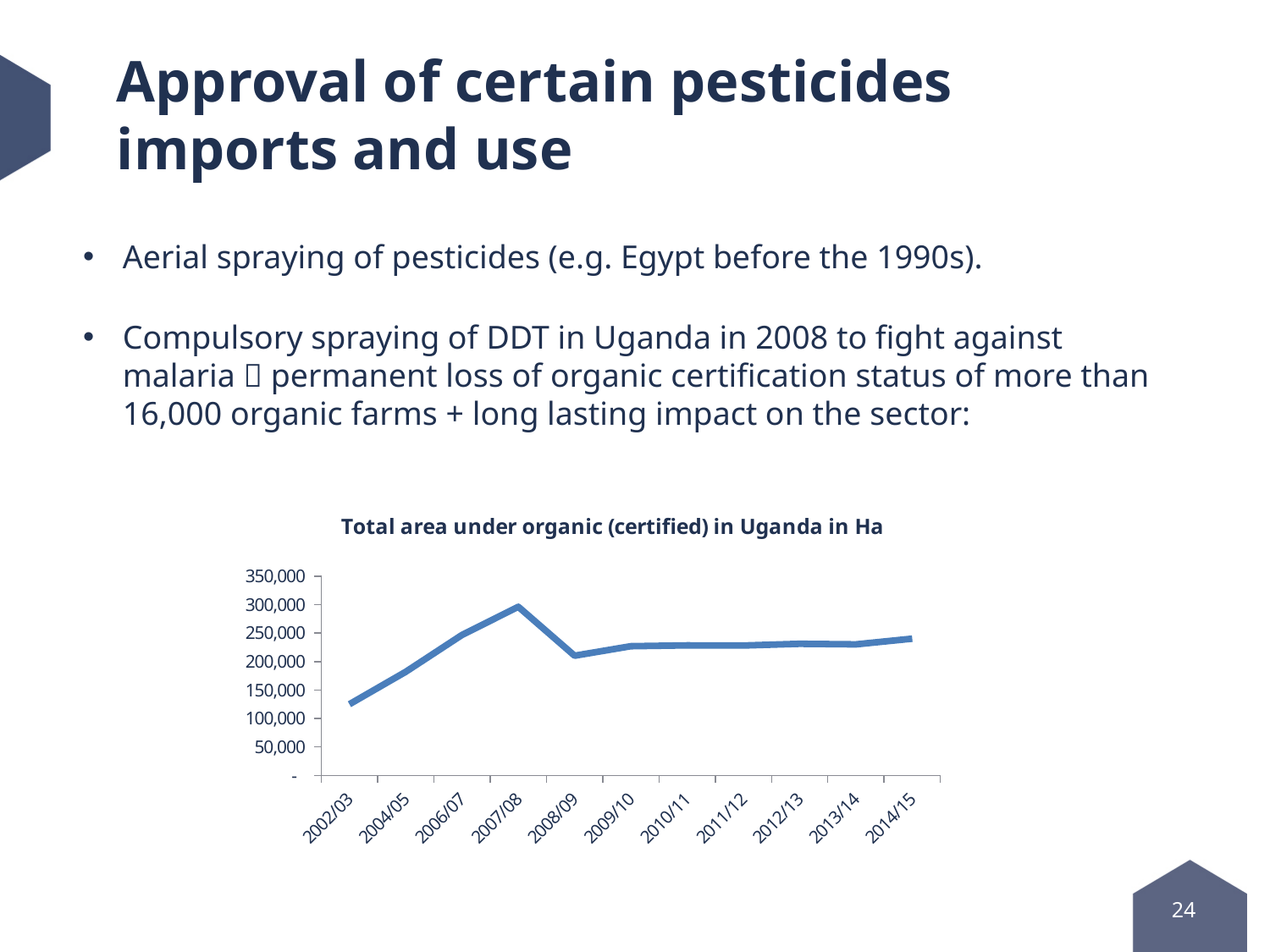
Is the value for 2007/08 greater or less than 250,000? greater What kind of chart is shown on the slide? line chart Is the value for 2008/09 greater or less than 250,000? less Does the total area under organic rise or fall from 2002/03 to 2007/08? rise Does the total area under organic rise or fall from 2007/08 to 2008/09? fall Is the value for 2014/15 greater or less than 200,000? greater How many years are plotted on the x axis of the chart? 11 What is the title of the chart? Total area under organic (certified) in Uganda in Ha Which year has the highest total area under organic in the chart? 2007/08 Which year has the lowest total area under organic in the chart? 2002/03 Which is larger, the value for 2007/08 or the value for 2008/09? 2007/08